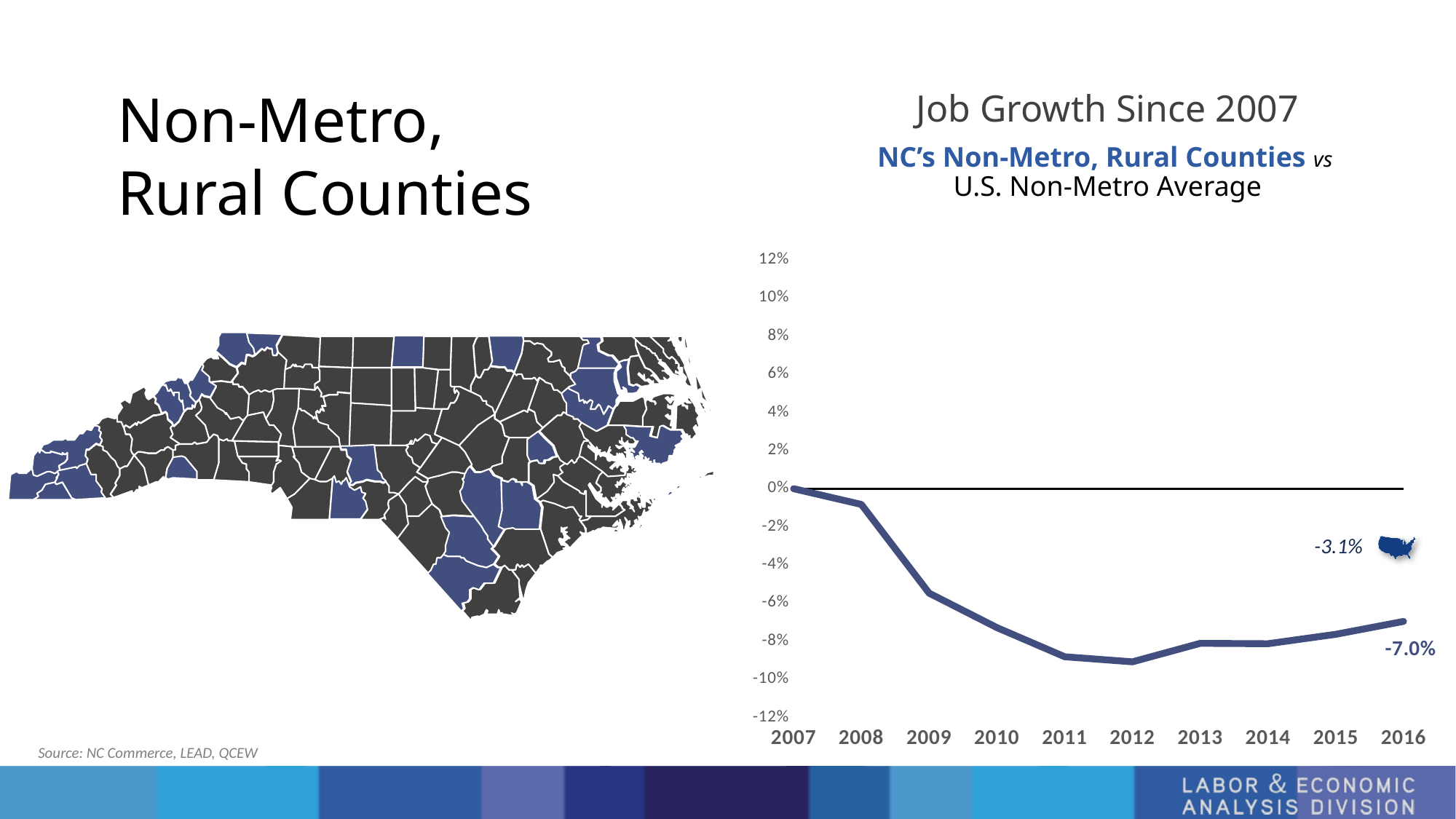
How many years are shown on the x axis of the Job Growth Since 2007 chart? 10 In the Job Growth Since 2007 chart, which is higher in 2016: NC's Non-Metro, Rural Counties or the U.S. Non-Metro Average? U.S. Non-Metro Average What kind of chart is shown on the right side of the slide? line chart In the Job Growth Since 2007 chart, is the NC Non-Metro, Rural Counties value for 2009 greater or less than -4%? less In the Job Growth Since 2007 chart, in which year is the NC Non-Metro, Rural Counties line at its highest? 2007 In the Job Growth Since 2007 chart, is the NC Non-Metro, Rural Counties value for 2008 greater or less than -2%? greater What is the title of the chart on the right side of the slide? Job Growth Since 2007 In the Job Growth Since 2007 chart, what is the 2016 value for NC's Non-Metro, Rural Counties? -7.0% In the Job Growth Since 2007 chart, what is the difference between the U.S. Non-Metro Average (-3.1%) and NC's Non-Metro, Rural Counties (-7.0%) in 2016? 3.9 percentage points In the Job Growth Since 2007 chart, does the NC Non-Metro, Rural Counties line rise or fall from 2012 to 2016? rise In the Job Growth Since 2007 chart, what is the 2016 value for the U.S. Non-Metro Average? -3.1% In the Job Growth Since 2007 chart, in which year does the NC Non-Metro, Rural Counties line reach its lowest point? 2012